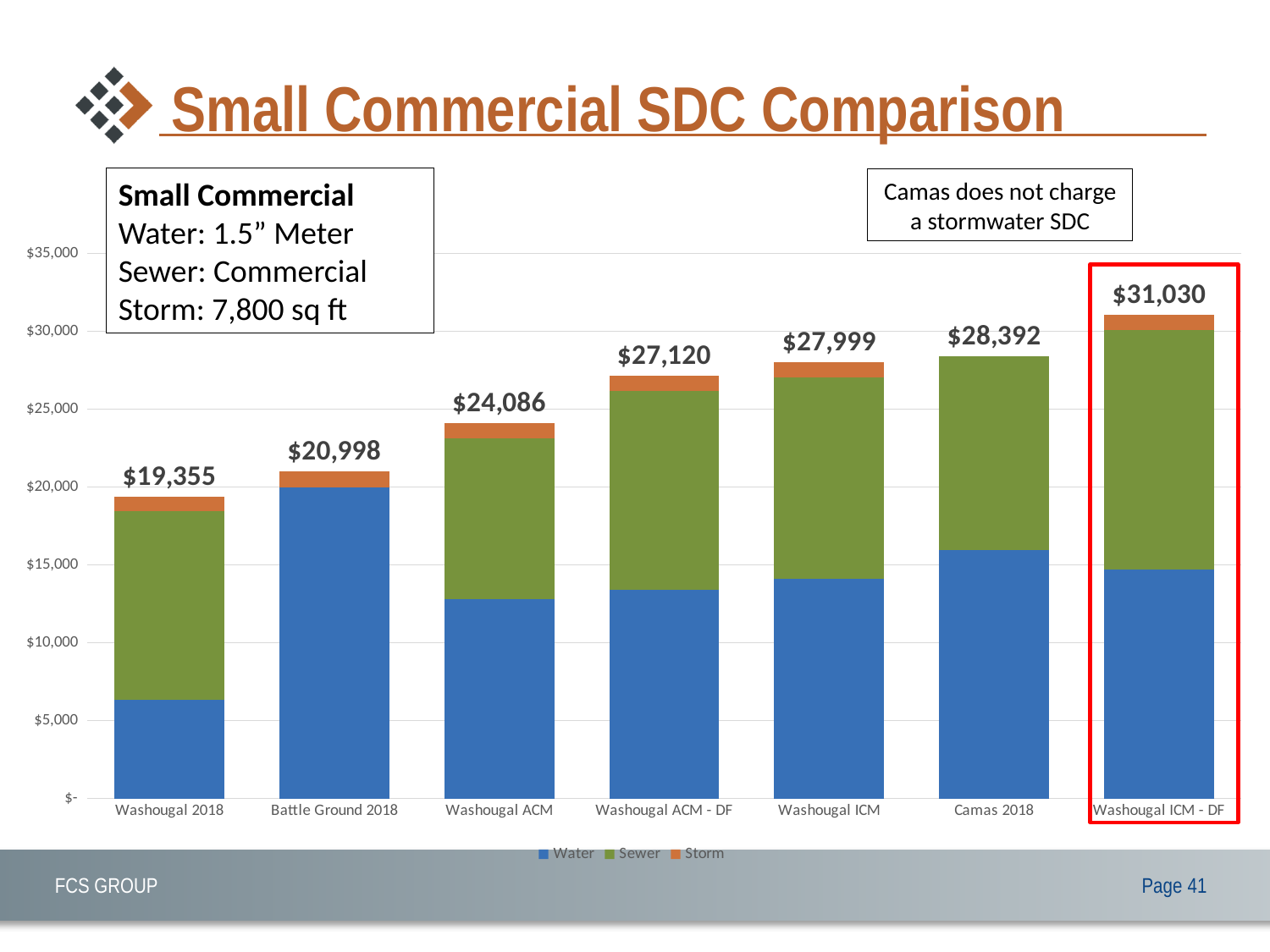
Which category has the lowest total SDC? Washougal 2018 What is the difference between the total SDC for Washougal ACM - DF and Washougal ACM? $3,034 Which category has the highest total SDC? Washougal ICM - DF What is the difference between the total SDC for Washougal ICM - DF and Washougal 2018? $11,675 What kind of chart is shown on the slide? Stacked bar chart What is the total small commercial SDC shown for Washougal ICM - DF? $31,030 What is the total small commercial SDC shown for Washougal 2018? $19,355 How many categories are shown on the x axis? 7 Which has a larger total SDC, Camas 2018 or Washougal ICM? Camas 2018 What is the total small commercial SDC shown for Camas 2018? $28,392 How many series does the legend list? 3 Is the Water portion of the Washougal 2018 bar greater or less than $5,000? greater